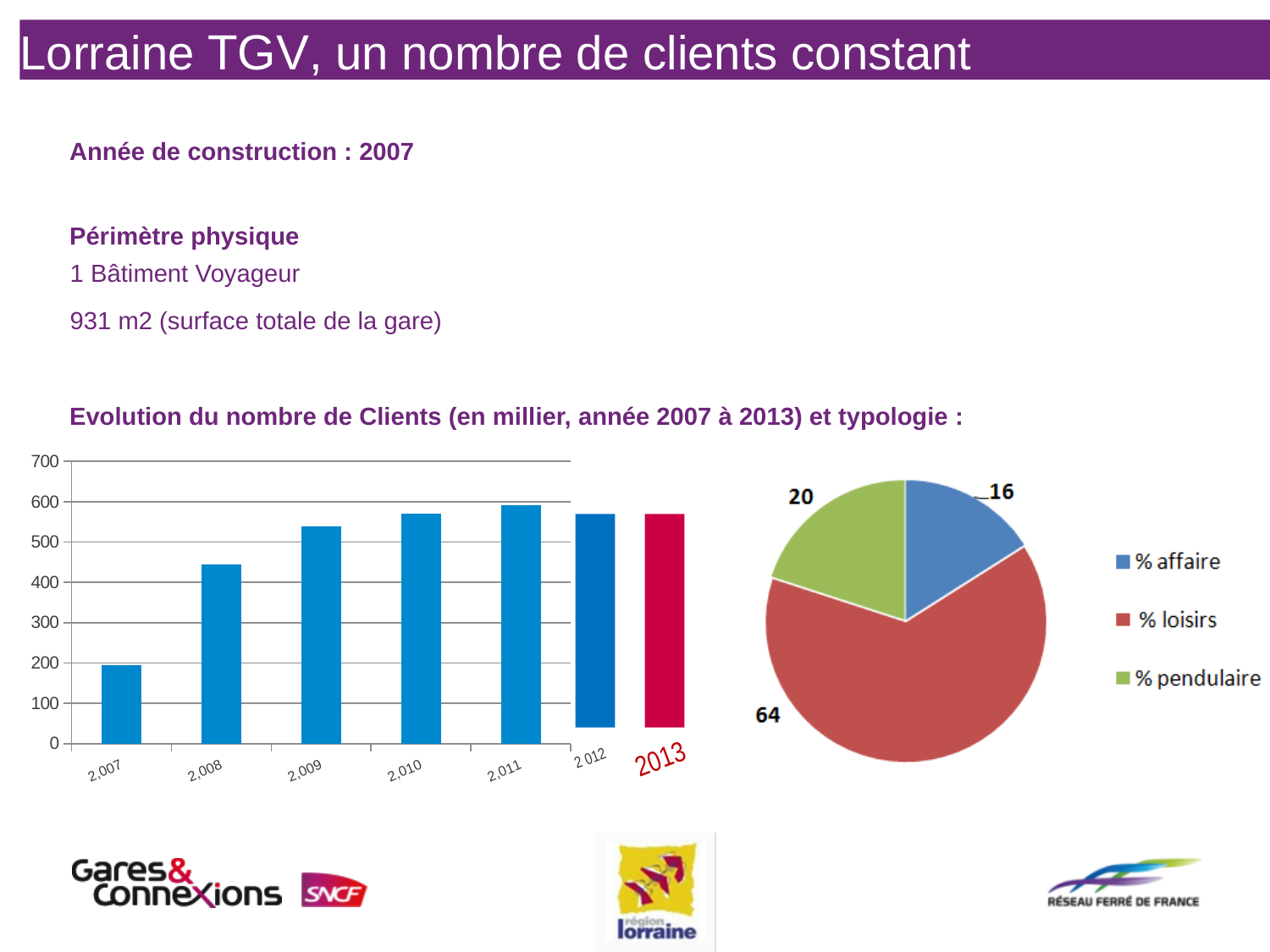
In the pie chart on the right, which category has the largest slice? % loisirs In the pie chart on the right, what is the value for % affaire? 16 How many years (bars) are shown in the bar chart on the left? 7 How many entries does the legend of the pie chart on the right list? 3 What kind of chart is the chart on the left showing the number of clients from 2007 to 2013? bar chart In the bar chart on the left, is the value for 2008 greater or less than 400? greater In the pie chart on the right, which category has the smallest slice? % affaire In the pie chart on the right, what is the difference between the values for % loisirs and % pendulaire? 44 In the pie chart on the right, what is the value for % loisirs? 64 In the bar chart on the left, is the value for 2010 greater or less than 500? greater In the pie chart on the right, what is the value for % pendulaire? 20 In the bar chart on the left, which year has the lowest value? 2007